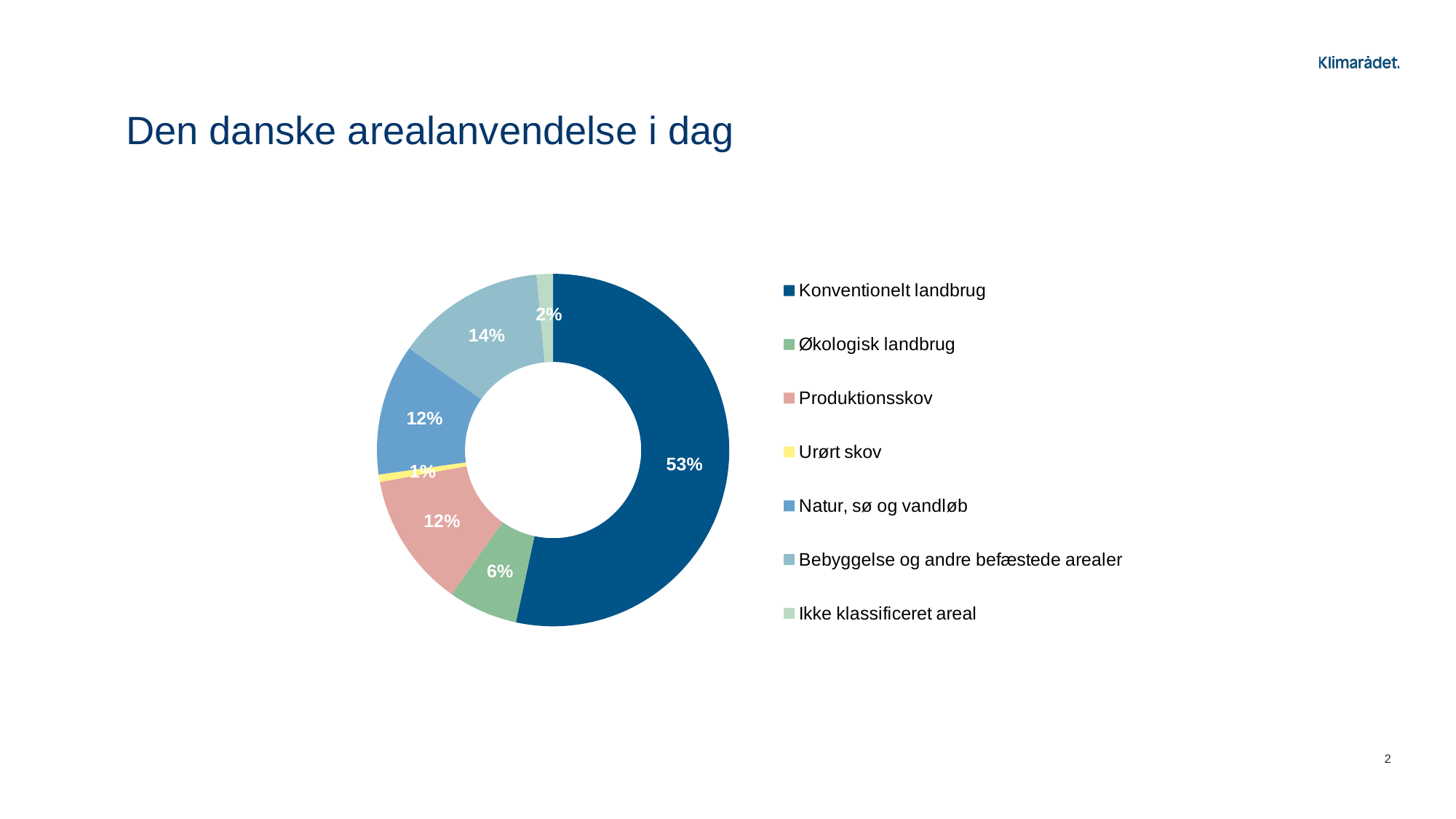
What share of the pie does Konventionelt landbrug account for? 53% How many categories does the legend list? 7 What is the value shown for Bebyggelse og andre befæstede arealer? 14% What is the value shown for Ikke klassificeret areal? 2% What is the value shown for Urørt skov? 1% Which category has the smallest slice of the chart? Urørt skov Which is larger, the share for Økologisk landbrug or the share for Produktionsskov? Produktionsskov What kind of chart is shown on the slide? Pie chart (donut) What is the difference between the shares of Konventionelt landbrug and Bebyggelse og andre befæstede arealer? 39 percentage points What is the value shown for Økologisk landbrug? 6% Which category has the largest slice of the chart? Konventionelt landbrug What is the title of the slide containing the chart? Den danske arealanvendelse i dag